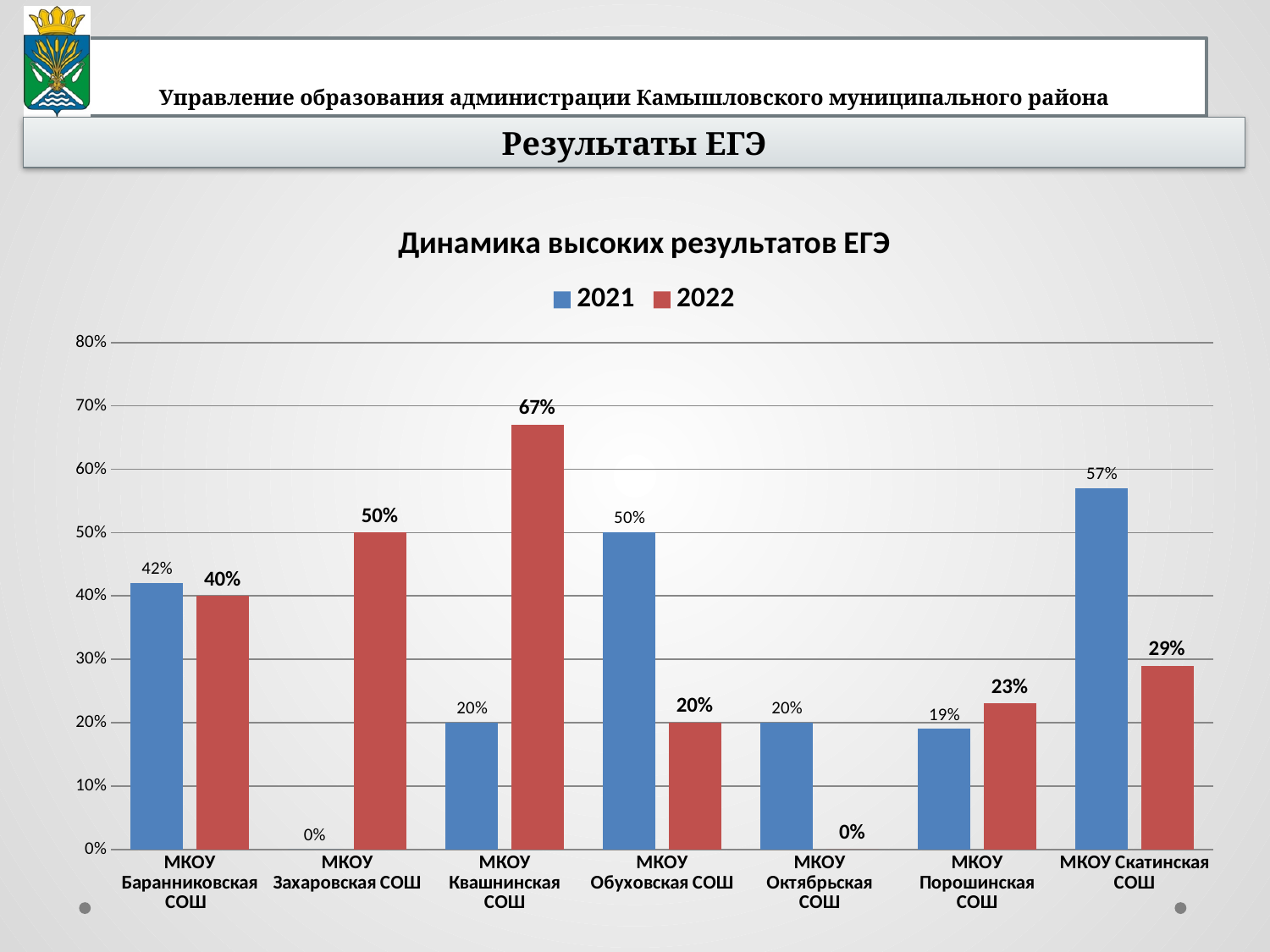
How many schools are shown on the x axis? 7 Which is larger for МКОУ Порошинская СОШ, the 2021 value or the 2022 value? 2022 How many series does the legend list? 2 What is the 2021 value for МКОУ Скатинская СОШ? 57% Which school has the highest 2022 value? МКОУ Квашнинская СОШ Which is larger for МКОУ Обуховская СОШ, the 2021 value or the 2022 value? 2021 What type of chart is shown? Bar chart What is the 2021 value for МКОУ Захаровская СОШ? 0% Which school has the lowest 2022 value? МКОУ Октябрьская СОШ What is the difference between the 2022 and 2021 values for МКОУ Квашнинская СОШ? 47% What is the 2022 value for МКОУ Квашнинская СОШ? 67% What is the difference between the 2021 and 2022 values for МКОУ Скатинская СОШ? 28%